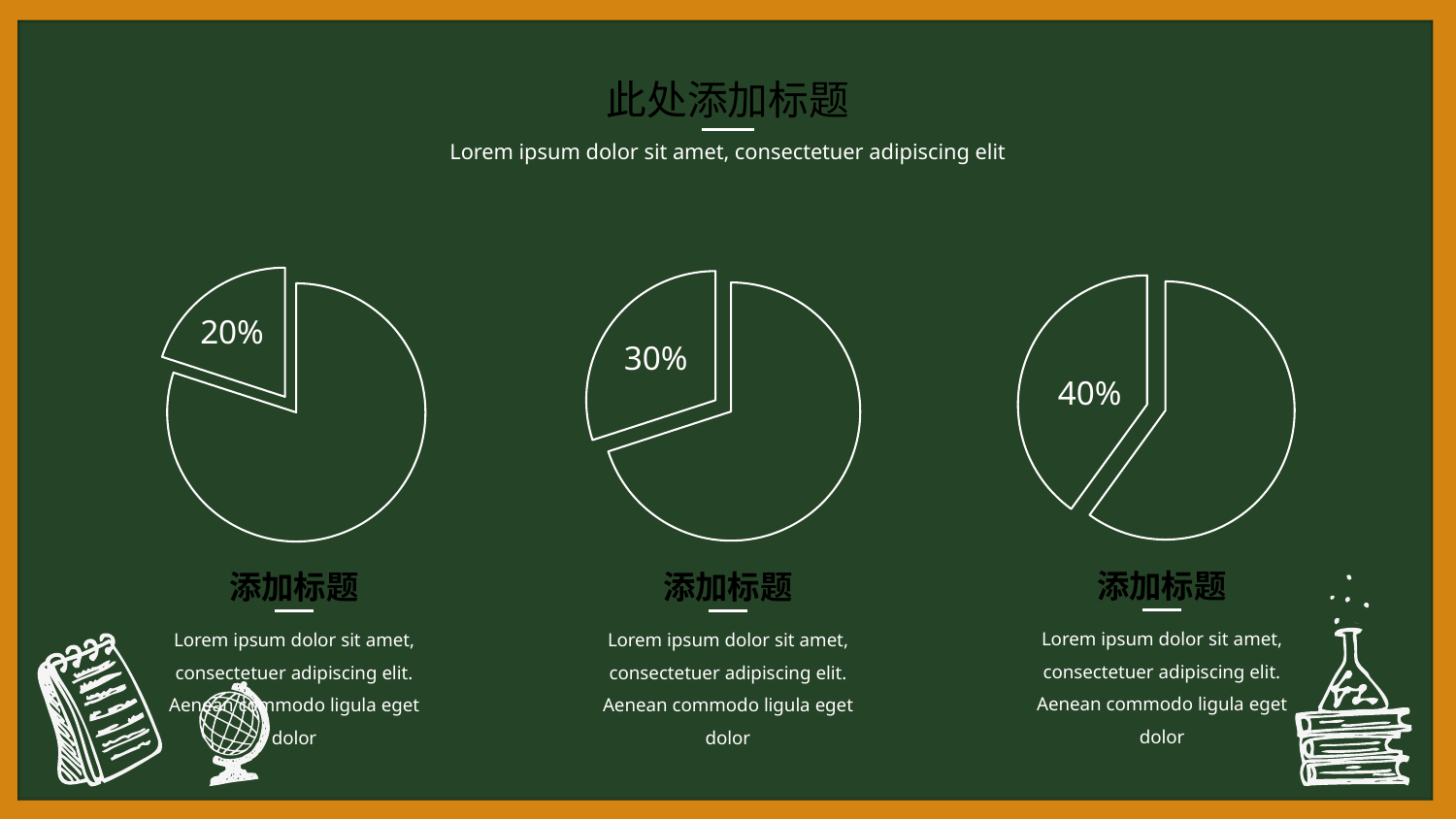
Which pie chart has the smallest labeled slice: the left, middle, or right one? Left What colour are the outlines of the pie charts on the slide? White Which pie chart has the largest labeled slice: the left, middle, or right one? Right What kind of chart is used for the three charts on the slide? Pie chart How many pie charts are on the slide? 3 Is the labeled slice in the middle pie chart larger or smaller than the labeled slice in the left pie chart? Larger How many slices does the left pie chart have? 2 In the right pie chart, is the labeled slice larger or smaller than the unlabeled slice? Smaller What is the difference between the labeled slice in the right pie chart and the labeled slice in the left pie chart? 20% In the middle pie chart, what percentage is shown on the exploded slice? 30% In the left pie chart, what percentage is shown on the exploded slice? 20% In the right pie chart, what percentage is shown on the exploded slice? 40%